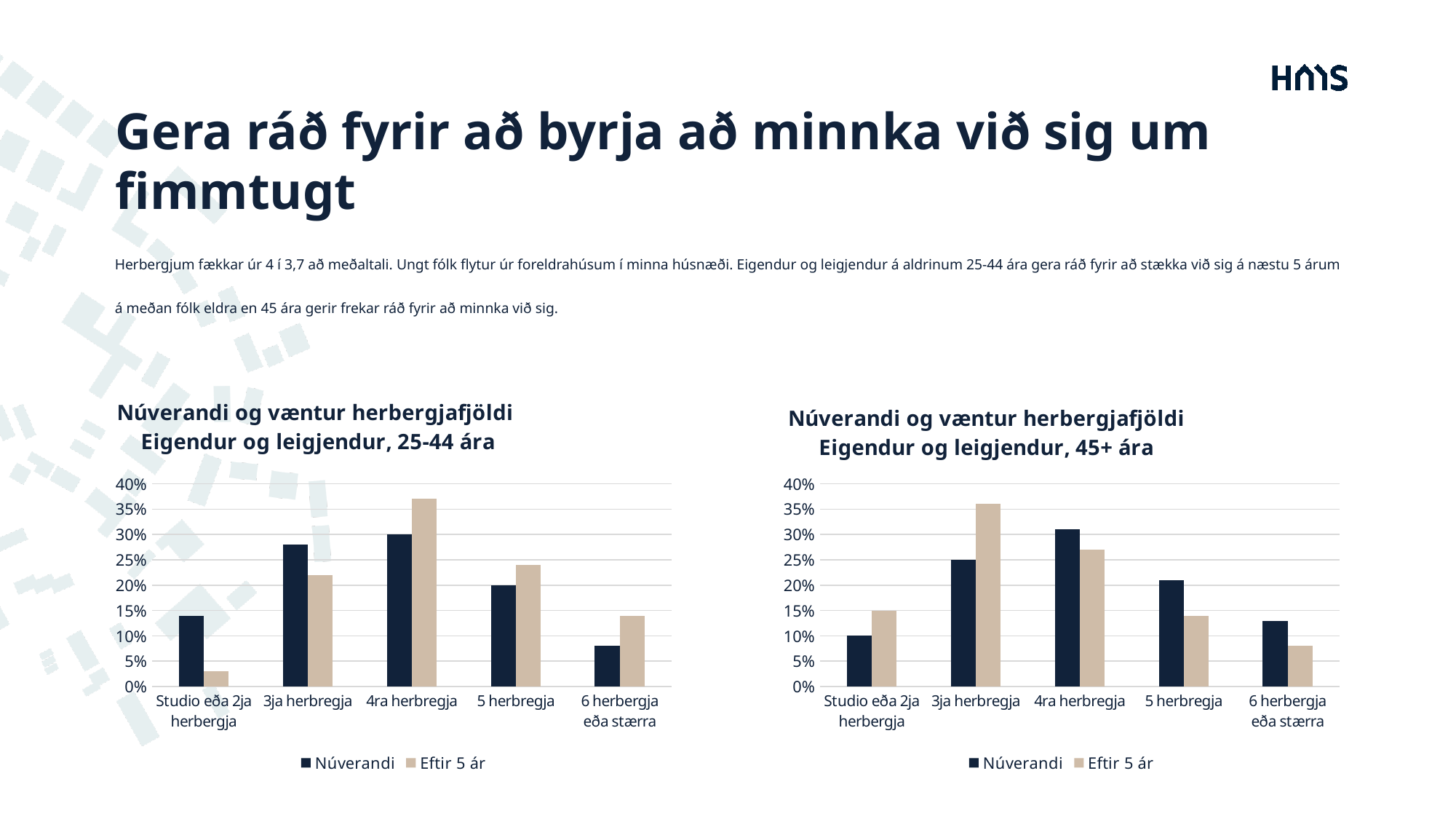
How many categories are shown on the x axis of the left chart, 'Eigendur og leigjendur, 25-44 ára'? 5 What are the two legend entries on the left chart, 'Eigendur og leigjendur, 25-44 ára'? Núverandi and Eftir 5 ár In the left chart, 'Eigendur og leigjendur, 25-44 ára', which is larger for 3ja herbregja: 'Núverandi' or 'Eftir 5 ár'? Núverandi In the left chart, 'Eigendur og leigjendur, 25-44 ára', which category has the lowest 'Eftir 5 ár' value? Studio eða 2ja herbergja In the right chart, 'Eigendur og leigjendur, 45+ ára', is the 'Eftir 5 ár' value for 6 herbergja eða stærra greater or less than 10%? less In the left chart, 'Eigendur og leigjendur, 25-44 ára', is the 'Eftir 5 ár' value for 4ra herbregja greater or less than 35%? greater In the left chart, 'Eigendur og leigjendur, 25-44 ára', which category has the highest 'Eftir 5 ár' value? 4ra herbregja In the right chart, 'Eigendur og leigjendur, 45+ ára', which category has the lowest 'Núverandi' value? Studio eða 2ja herbergja What kind of chart is the left chart, 'Eigendur og leigjendur, 25-44 ára'? bar chart In the right chart, 'Eigendur og leigjendur, 45+ ára', which is larger for 5 herbregja: 'Núverandi' or 'Eftir 5 ár'? Núverandi How many series does the legend list on the right chart, 'Eigendur og leigjendur, 45+ ára'? 2 In the right chart, 'Eigendur og leigjendur, 45+ ára', which category has the highest 'Eftir 5 ár' value? 3ja herbregja